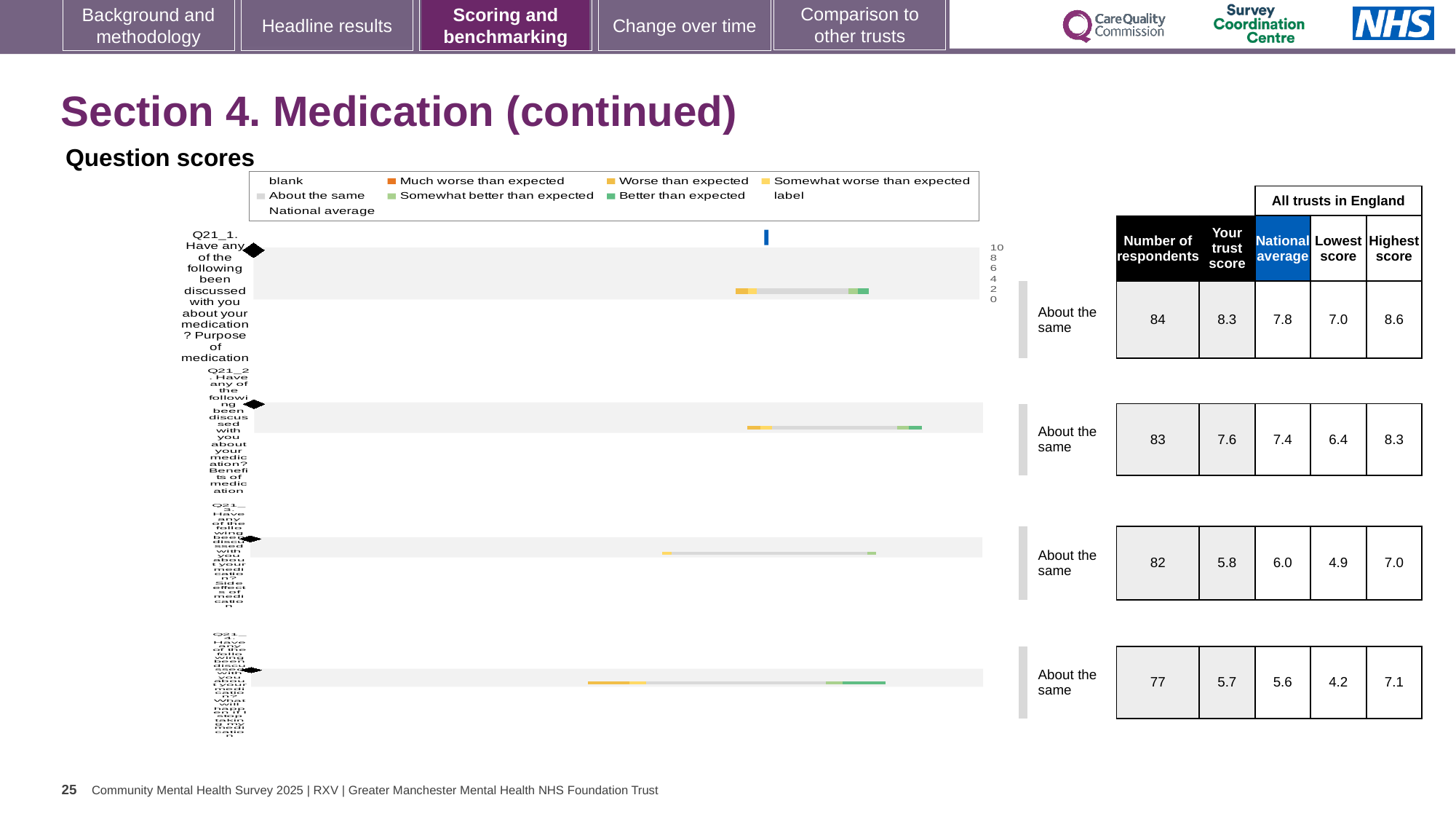
How many question rows (Q21_1 to Q21_4) are charted on the slide? 4 What kind of chart is used to show the question scores on this slide? bar chart According to the table beside the charts, what is your trust score for Q21_1 (Purpose of medication)? 8.3 Which legend entry is shown in dark orange? Much worse than expected How many entries does the legend above the charts list? 9 Which question row has the highest number of respondents? Q21_1 For Q21_1, which is larger: your trust score or the national average? Your trust score How many respondents are listed for Q21_3 (Side effects of medication)? 82 What is the heading above the charts on this slide? Question scores For Q21_2 (Benefits of medication), what is the difference between the highest score and the lowest score in the table? 1.9 According to the table beside the charts, what is the national average for Q21_4 (What will happen if I stop taking medication)? 5.6 What benchmark category is shown next to the chart for Q21_1 (Purpose of medication)? About the same